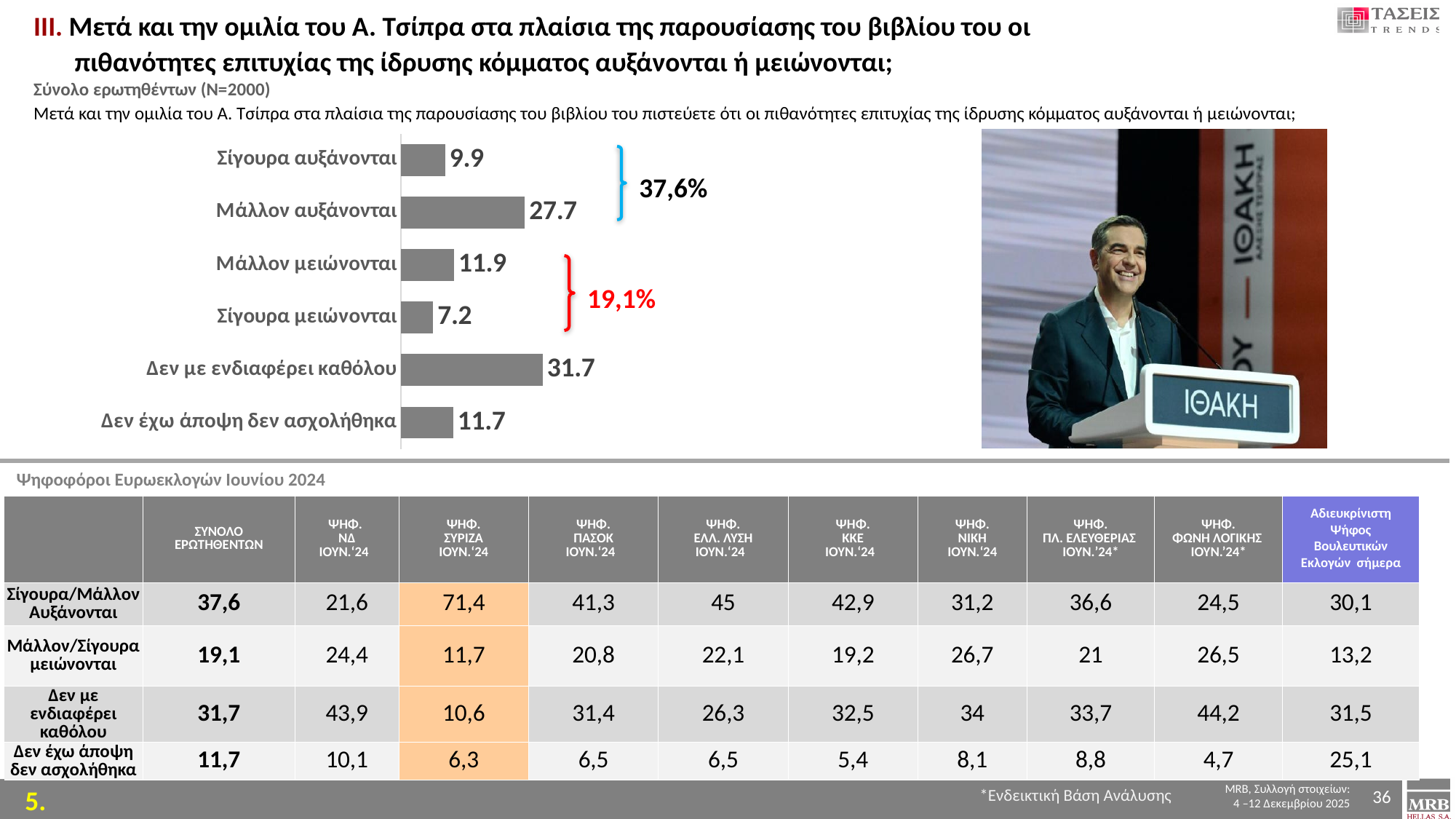
What is the difference between the values for "Μάλλον μειώνονται" and "Σίγουρα αυξάνονται" in the bar chart? 2.0 What combined percentage is shown by the red bracket next to the "Μάλλον μειώνονται" and "Σίγουρα μειώνονται" bars? 19,1% What is the difference between the values for "Δεν με ενδιαφέρει καθόλου" and "Μάλλον αυξάνονται" in the bar chart? 4.0 Which category has the highest value in the bar chart? Δεν με ενδιαφέρει καθόλου What is the value for "Μάλλον αυξάνονται" in the bar chart? 27.7 Which is larger in the bar chart: the value for "Σίγουρα αυξάνονται" or the value for "Μάλλον μειώνονται"? Μάλλον μειώνονται What is the value for "Σίγουρα μειώνονται" in the bar chart? 7.2 Which category has the lowest value in the bar chart? Σίγουρα μειώνονται How many categories are shown in the bar chart? 6 What is the value for "Δεν έχω άποψη δεν ασχολήθηκα" in the bar chart? 11.7 What kind of chart is shown on the slide? Bar chart What combined percentage is shown by the blue bracket next to the first two bars of the chart? 37,6%